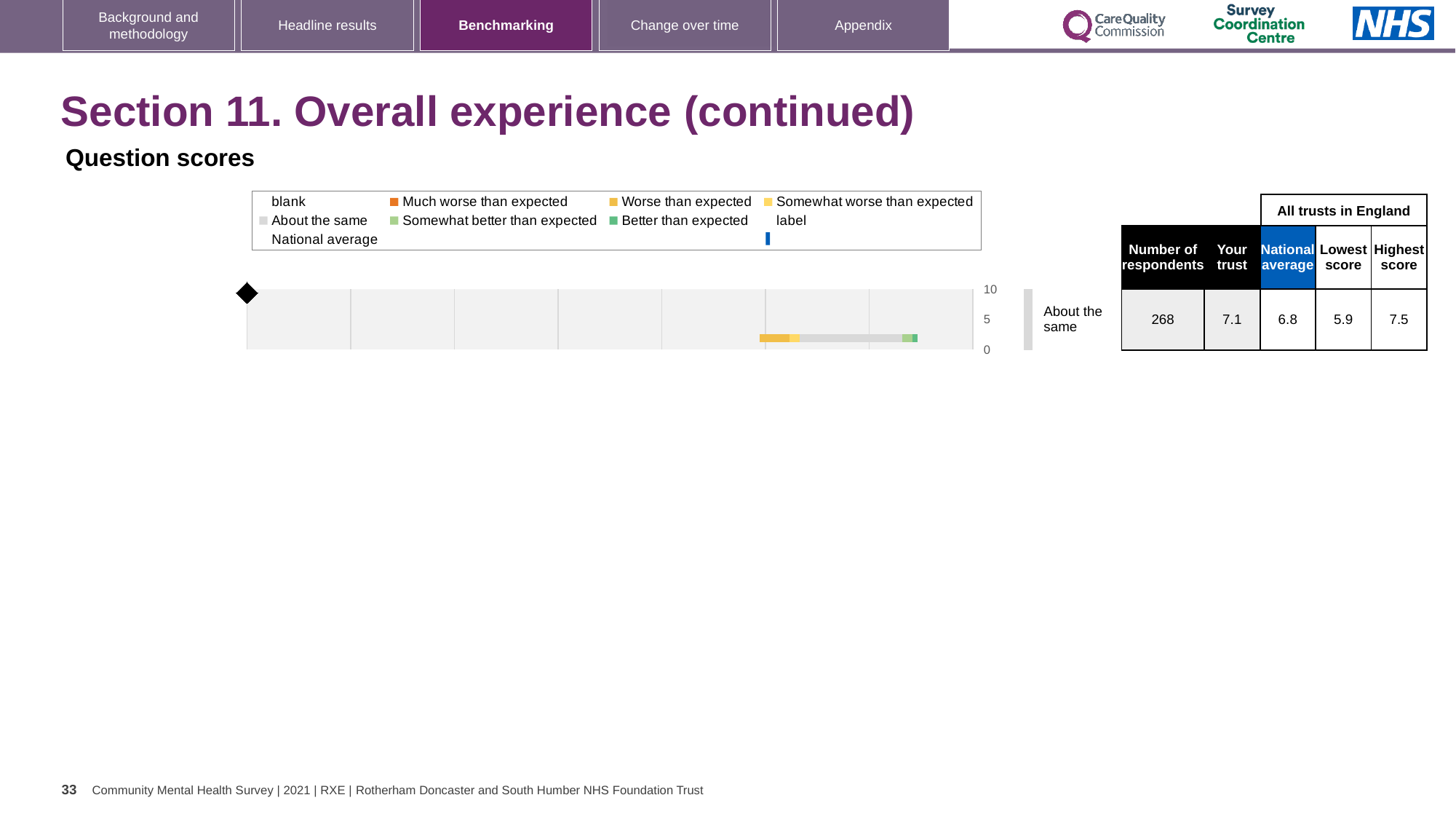
How many question categories are plotted in the chart? 1 By how much does the 'Your trust' score exceed the national average for this question? 0.3 What is the maximum value shown on the chart's score axis? 10 What is the highest score among all trusts in England for this question? 7.5 What is the 'Your trust' score for the question rated 'About the same'? 7.1 What is the difference between the highest score and the lowest score for this question? 1.6 What kind of chart is shown under 'Question scores'? bar chart What benchmark category label is shown next to the bar in the chart? About the same How many respondents are recorded for the question rated 'About the same'? 268 What is the lowest score among all trusts in England for this question? 5.9 Which is higher for this question, the 'Your trust' score or the national average? Your trust What is the national average score shown for the question rated 'About the same'? 6.8